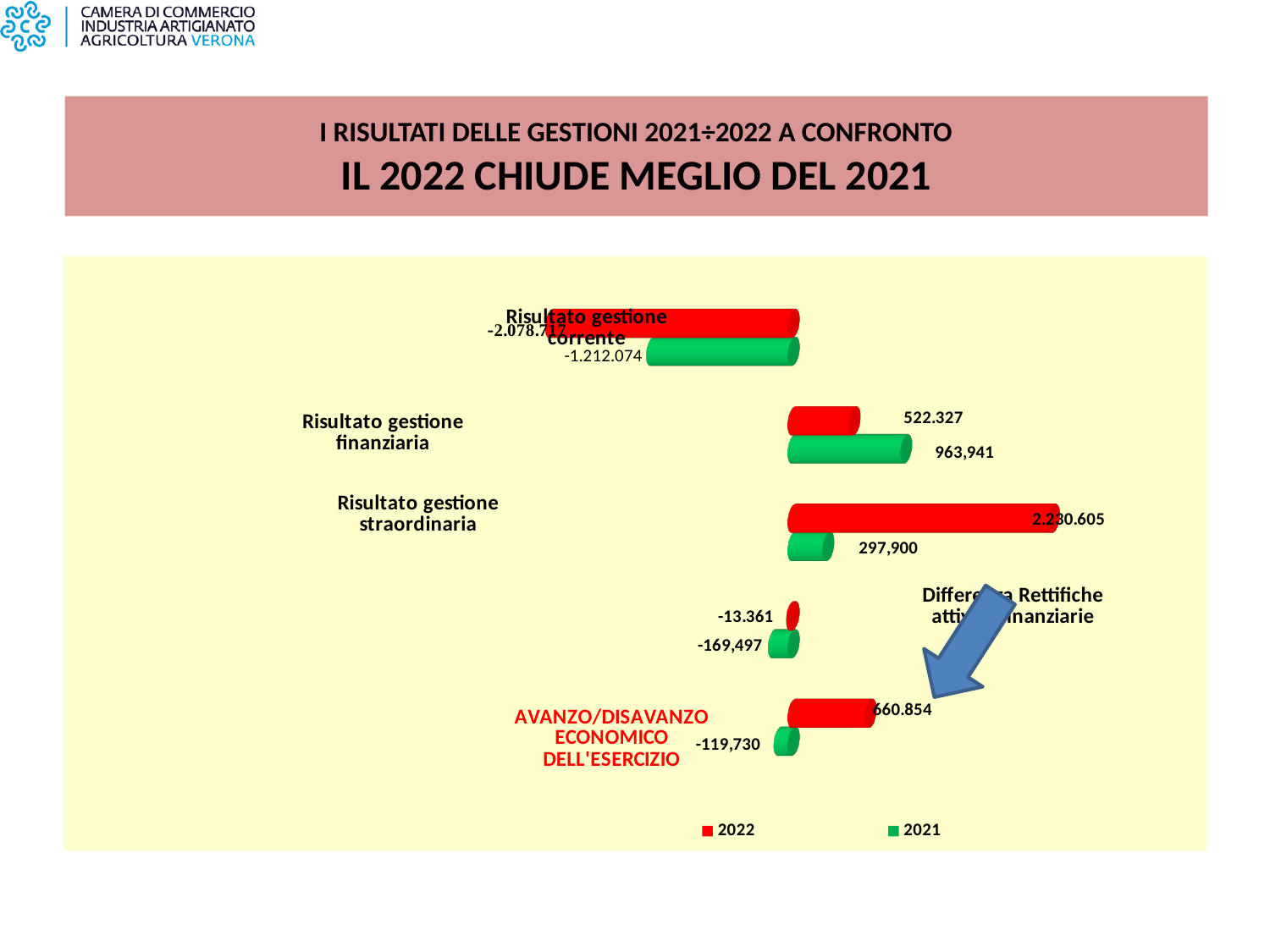
What is the 2021 value for Risultato gestione finanziaria? 963,941 For Risultato gestione finanziaria, which year has the larger value, 2022 or 2021? 2021 What is the 2021 value for Risultato gestione corrente? -1.212.074 How many categories are shown in the chart? 5 What is the 2022 value for Differenza Rettifiche attività finanziarie? -13.361 What kind of chart is shown on the slide? Bar chart What is the 2022 value for Risultato gestione straordinaria? 2.230.605 Which category has the lowest 2021 value? Risultato gestione corrente How many series does the legend list? 2 Which category has the highest 2022 value? Risultato gestione straordinaria Which category has the highest 2021 value? Risultato gestione finanziaria What is the 2021 value for AVANZO/DISAVANZO ECONOMICO DELL'ESERCIZIO? -119,730